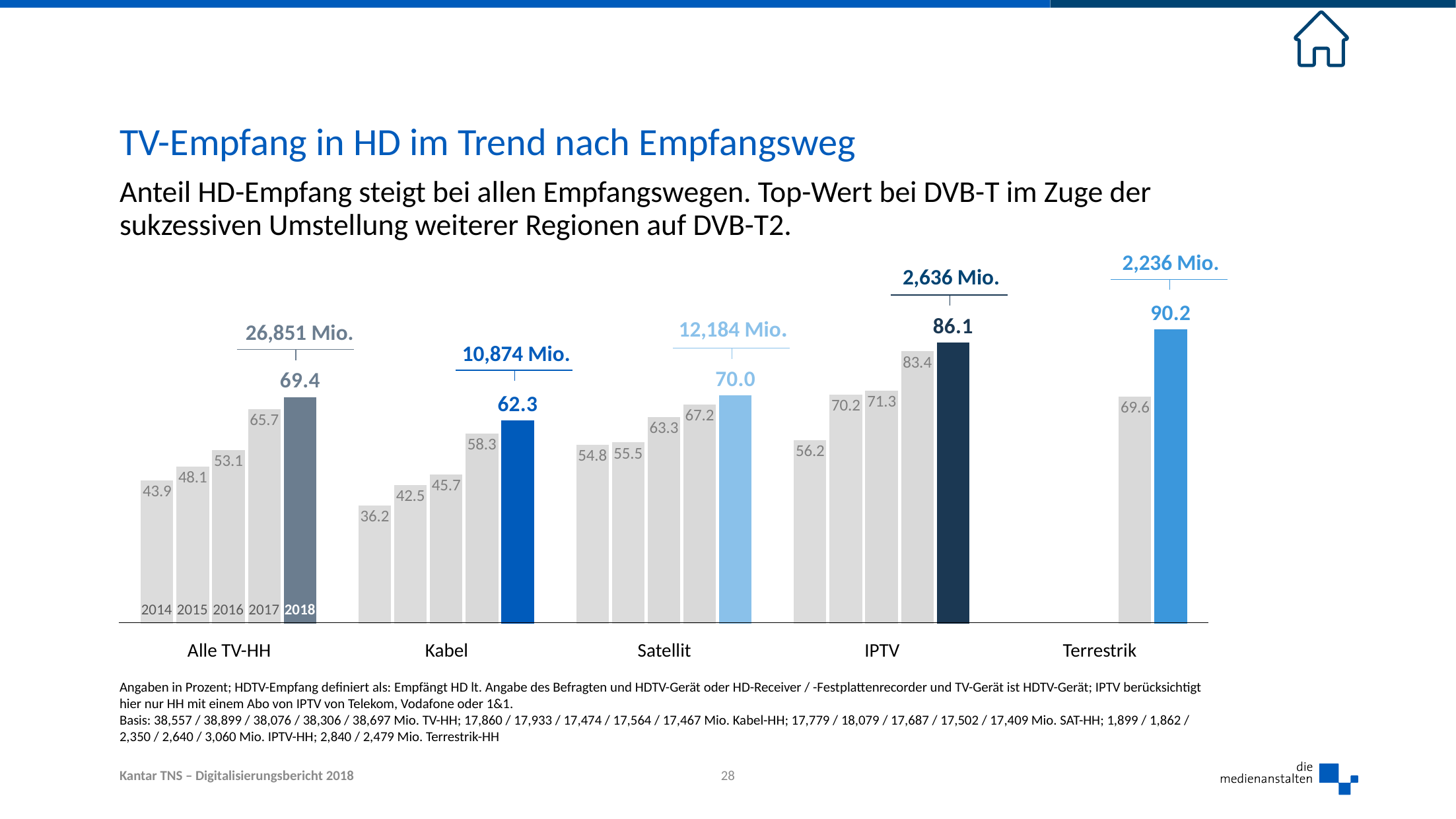
What is the 2017 value for Terrestrik? 69.6 Which is larger, the 2016 value for Satellit or the 2016 value for Alle TV-HH? Satellit What is the 2018 value for IPTV? 86.1 Do the values for Kabel rise or fall from 2014 to 2018? rise What number of households in Mio. is shown above the 2018 bar for Alle TV-HH? 26,851 Mio. What is the difference between the 2018 and 2017 values for Terrestrik? 20.6 What is the 2014 value for Satellit? 54.8 How many bars are shown for Terrestrik? 2 What is the difference between the 2018 values for IPTV and Satellit? 16.1 Which reception path has the lowest 2014 value? Kabel Which reception path has the highest 2018 value? Terrestrik What is the 2018 HD reception share for Kabel? 62.3